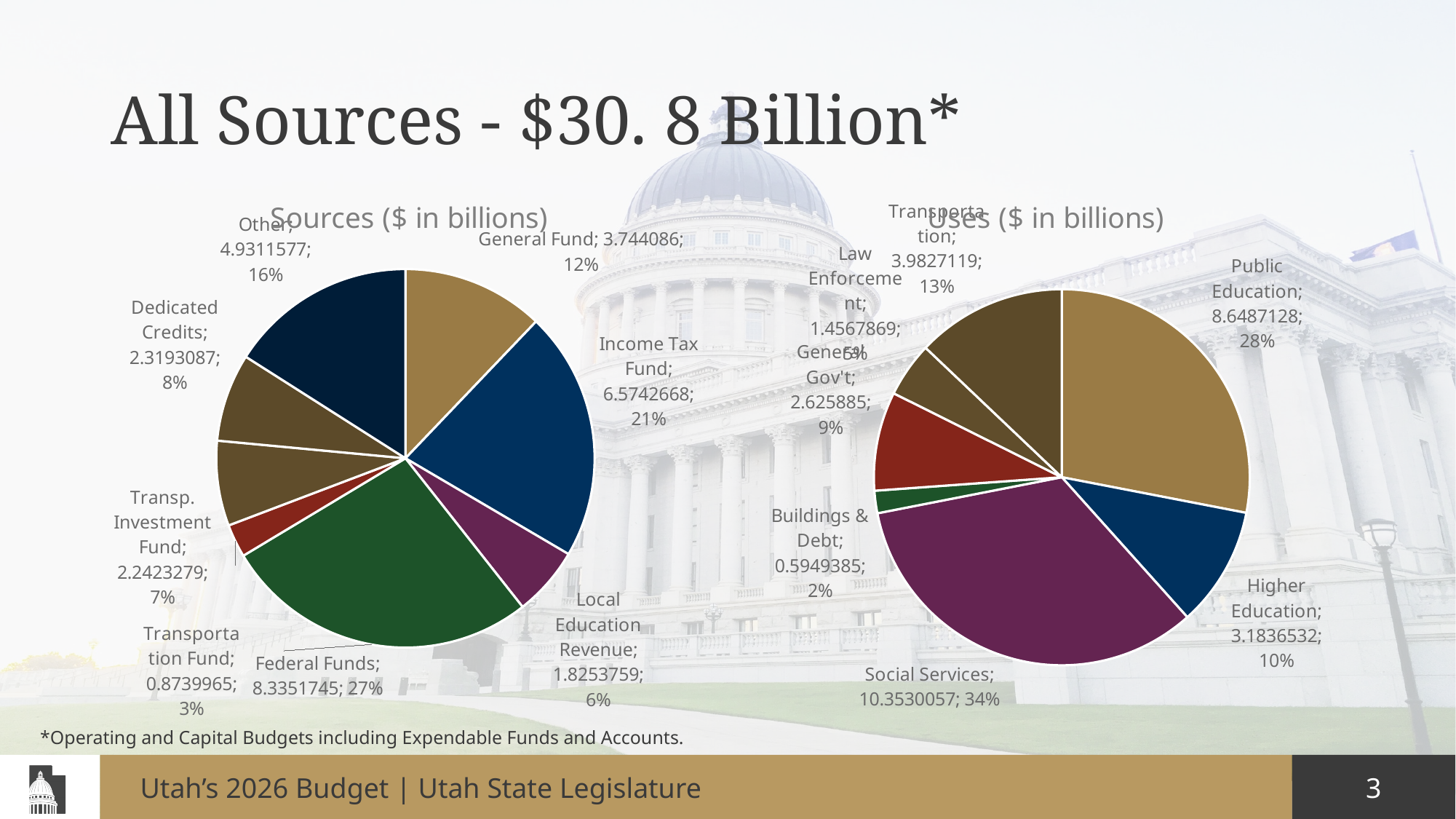
In the Uses ($ in billions) chart, what is the value for Social Services? 10.3530057 In the Sources ($ in billions) chart, what is the difference in percentage share between Federal Funds and General Fund? 15% In the Sources ($ in billions) chart, which category is the smallest? Transportation Fund In the Uses ($ in billions) chart, which category is the smallest? Buildings & Debt In the Sources ($ in billions) chart, which category is the largest? Federal Funds What type of chart is the Uses ($ in billions) chart? Pie chart How many categories are shown in the Uses ($ in billions) chart? 7 In the Sources ($ in billions) chart, what share of the pie is the Income Tax Fund? 21% In the Uses ($ in billions) chart, which is larger, Higher Education or Transportation? Transportation How many categories are shown in the Sources ($ in billions) chart? 8 In the Sources ($ in billions) chart, what is the value for Federal Funds? 8.3351745 In the Uses ($ in billions) chart, what share of the pie is Public Education? 28%